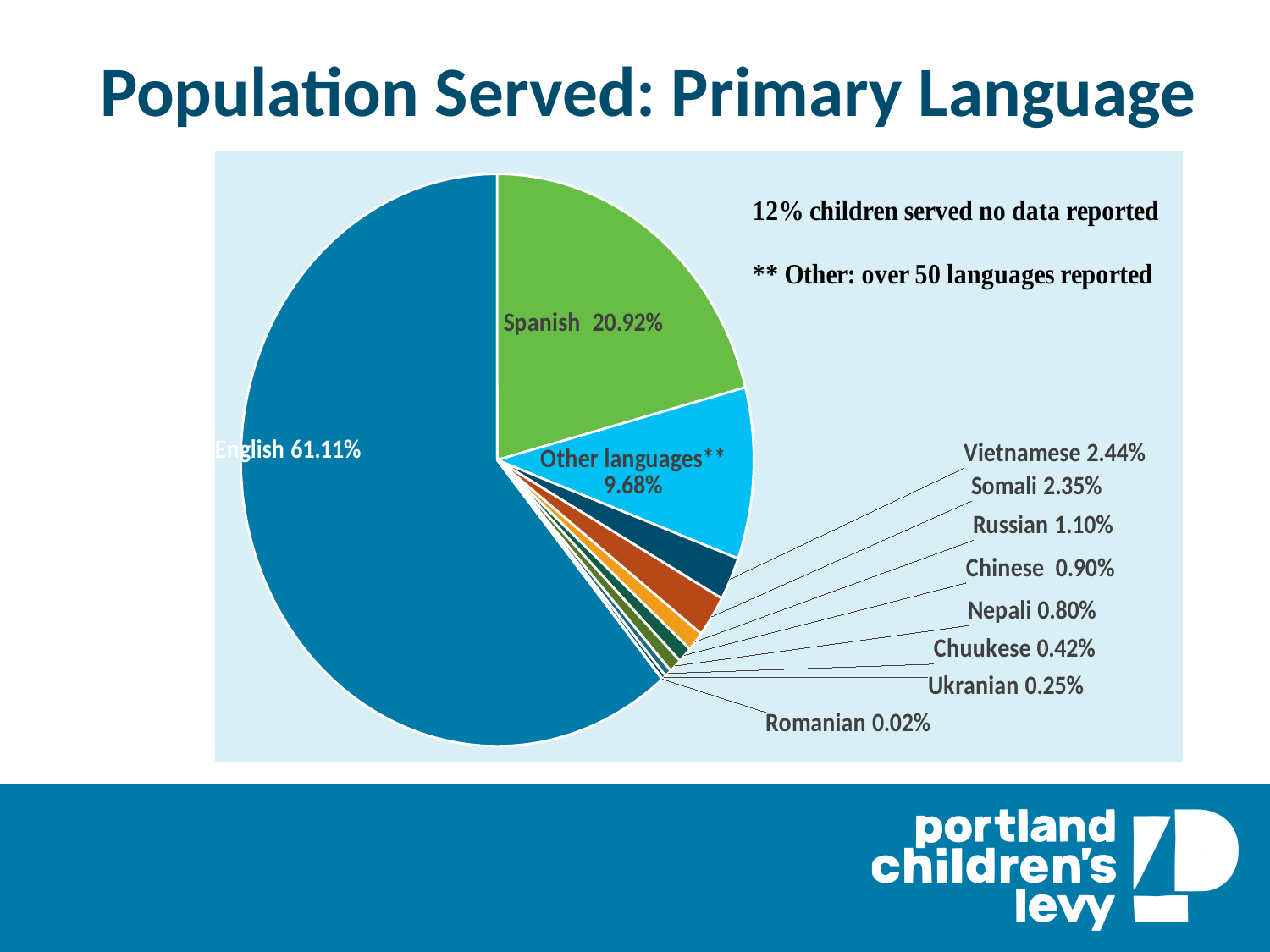
What share of the pie does Spanish represent? 20.92% Which language has the largest slice of the pie? English What is the value shown for Chuukese? 0.42% What is the title of the slide? Population Served: Primary Language What is the difference between the English and Spanish percentages? 40.19% How many slices does the pie chart have? 11 What is the value shown for English? 61.11% Which language has the smallest slice of the pie? Romanian What is the value shown for Other languages? 9.68% What is the value shown for Vietnamese? 2.44% Which is larger, the share for Russian or the share for Chinese? Russian What kind of chart is shown on the slide? Pie chart